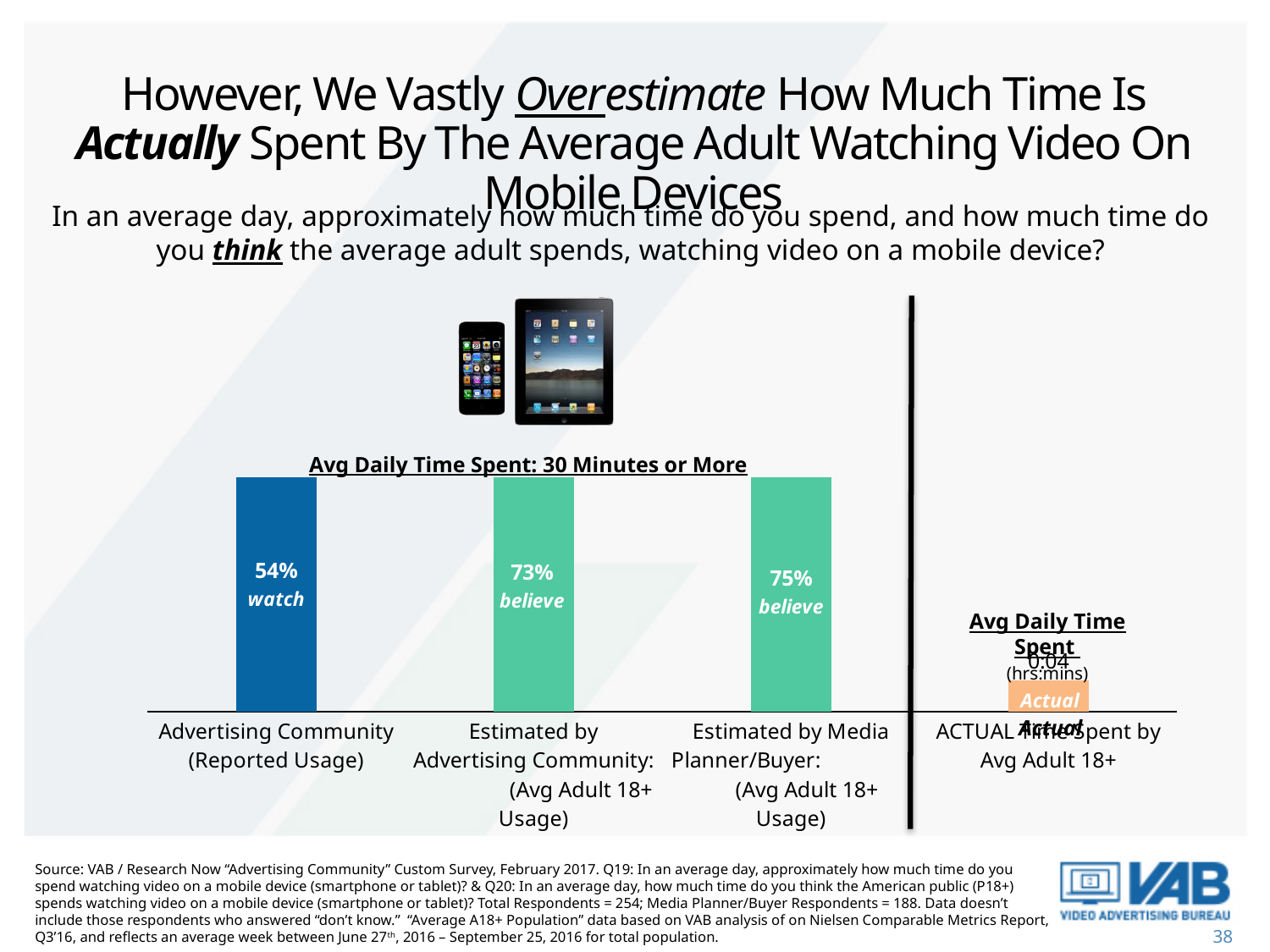
How many percentage bars are shown in the 'Avg Daily Time Spent: 30 Minutes or More' chart? 3 What is the difference in percentage points between the Media Planner/Buyer estimate and the Advertising Community's reported usage? 21 What is the title of the bar chart on the slide? Avg Daily Time Spent: 30 Minutes or More What percentage is shown for the bar labeled 'Estimated by Advertising Community: (Avg Adult 18+ Usage)'? 73% What is the difference in percentage points between the Advertising Community's estimate for the average adult and its own reported usage? 19 What percentage is shown for the bar labeled 'Estimated by Media Planner/Buyer: (Avg Adult 18+ Usage)'? 75% What percentage of the Advertising Community reports watching video on a mobile device for 30 minutes or more per day? 54% Which category has the highest percentage in the 'Avg Daily Time Spent: 30 Minutes or More' chart? Estimated by Media Planner/Buyer: (Avg Adult 18+ Usage) What is the actual average daily time spent (hrs:mins) watching video on a mobile device by the average adult 18+, as shown on the right of the slide? 0:04 Which is larger: the percentage estimated by the Advertising Community or the percentage estimated by Media Planner/Buyer? Estimated by Media Planner/Buyer What type of chart is used to show the 'Avg Daily Time Spent: 30 Minutes or More' data? Bar chart Which category has the lowest percentage in the 'Avg Daily Time Spent: 30 Minutes or More' chart? Advertising Community (Reported Usage)